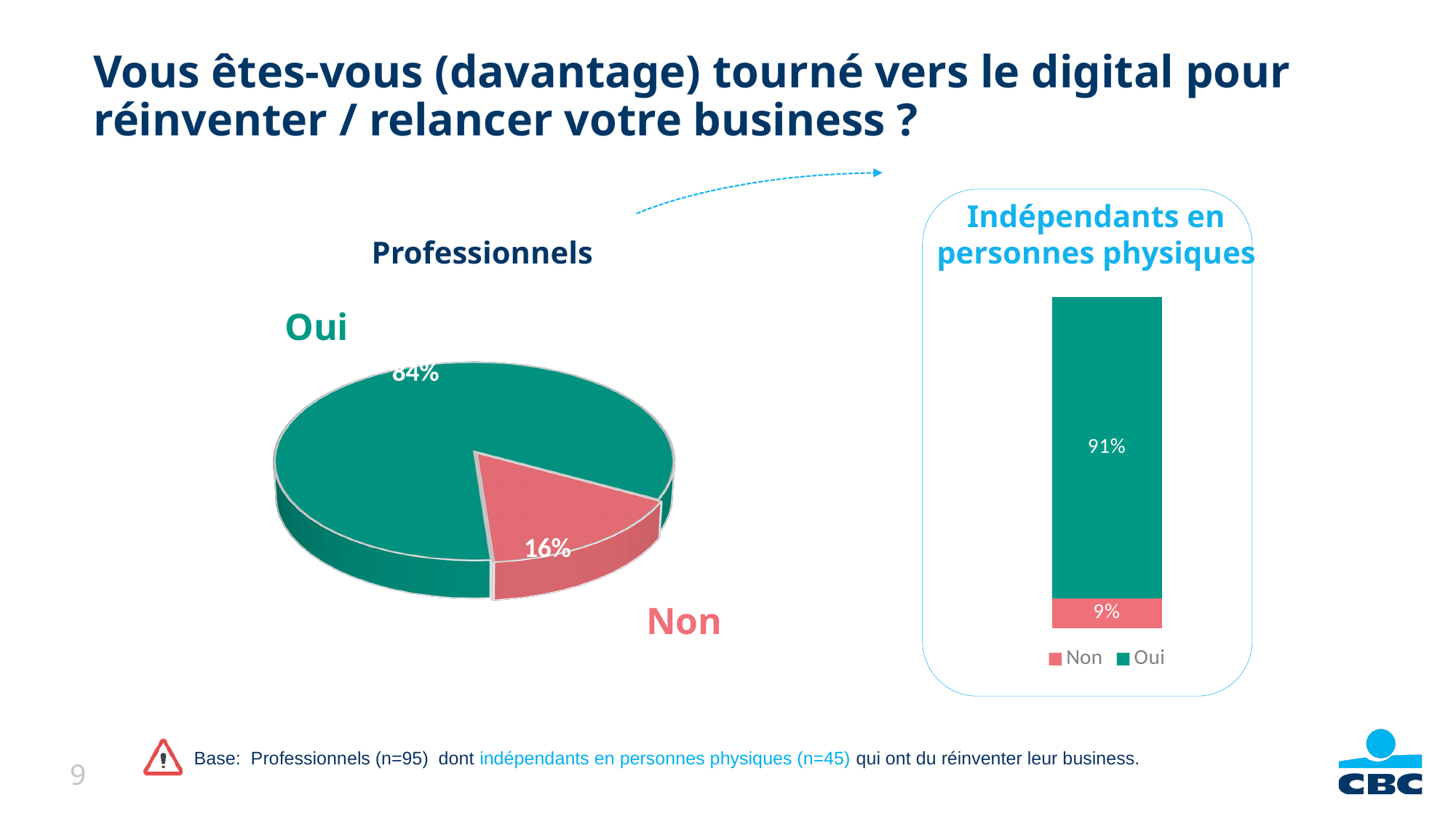
How many entries does the legend of the Indépendants en personnes physiques chart list? 2 In the Professionnels pie chart, what percentage answered Non? 16% In the Professionnels pie chart, what percentage answered Oui? 84% In the Indépendants en personnes physiques chart, what is the difference between Oui and Non? 82% In the Professionnels pie chart, what is the difference between the Oui and Non shares? 68% What kind of chart is the Indépendants en personnes physiques chart? stacked bar chart Is the Oui share for Professionnels larger or smaller than the Oui share for Indépendants en personnes physiques? smaller What kind of chart is the Professionnels chart? pie chart In the Indépendants en personnes physiques chart, what percentage answered Oui? 91% In the Indépendants en personnes physiques chart, which answer has the smallest value? Non In the Indépendants en personnes physiques chart, what percentage answered Non? 9% In the Professionnels pie chart, which answer has the largest share? Oui